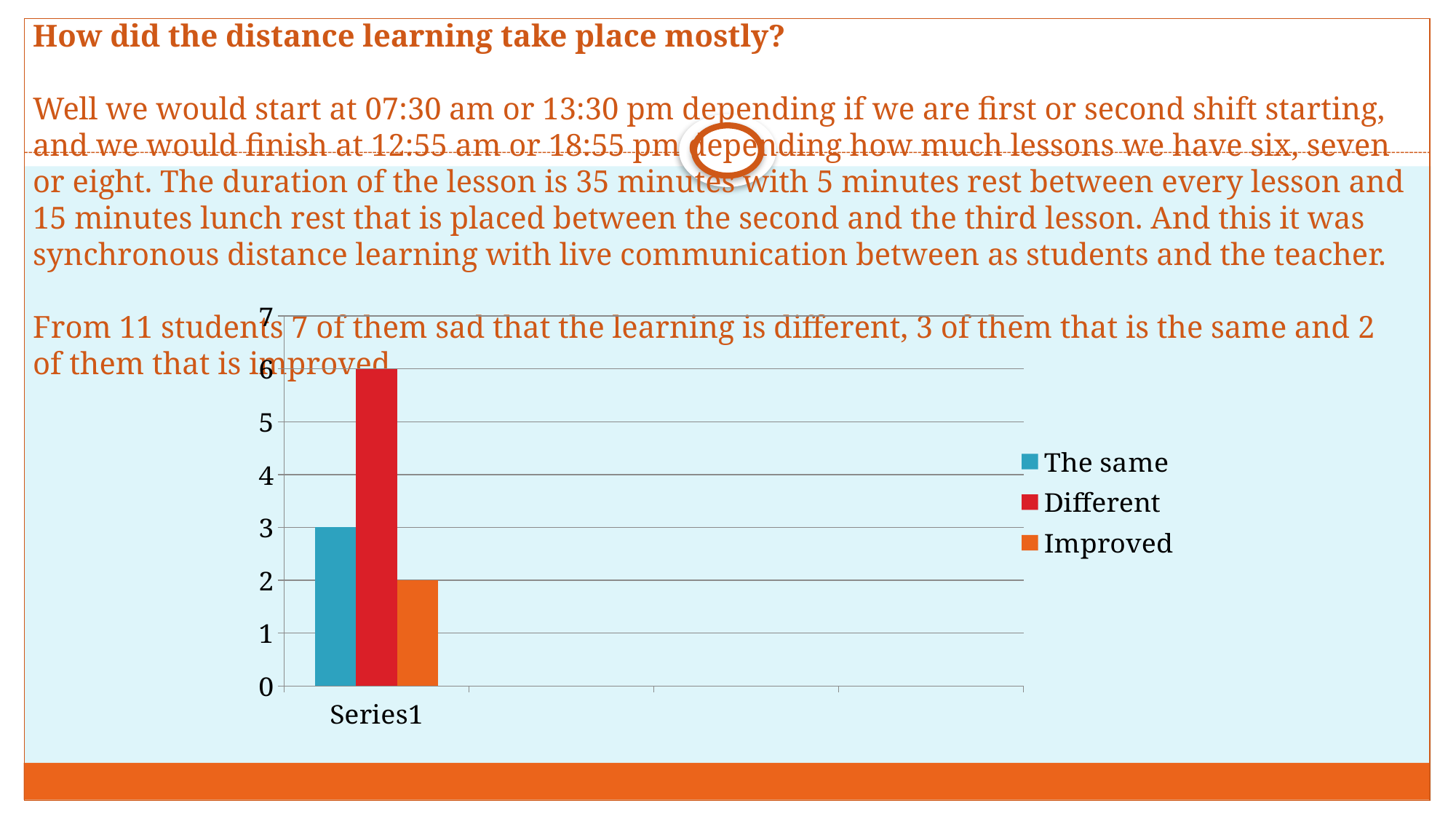
Which series has the highest bar? Different What is the category label shown on the x axis? Series1 Which series has the lowest bar? Improved What colour is the 'Different' bar? red What kind of chart is shown on the slide? bar chart Which is larger, the 'The same' bar or the 'Improved' bar? The same What is the value of the 'Different' bar? 6 What is the difference between the 'Different' bar and the 'The same' bar? 3 Is the value for 'Different' greater or less than 5? greater What is the value of the 'Improved' bar? 2 How many series does the chart legend list? 3 What is the value of the 'The same' bar? 3